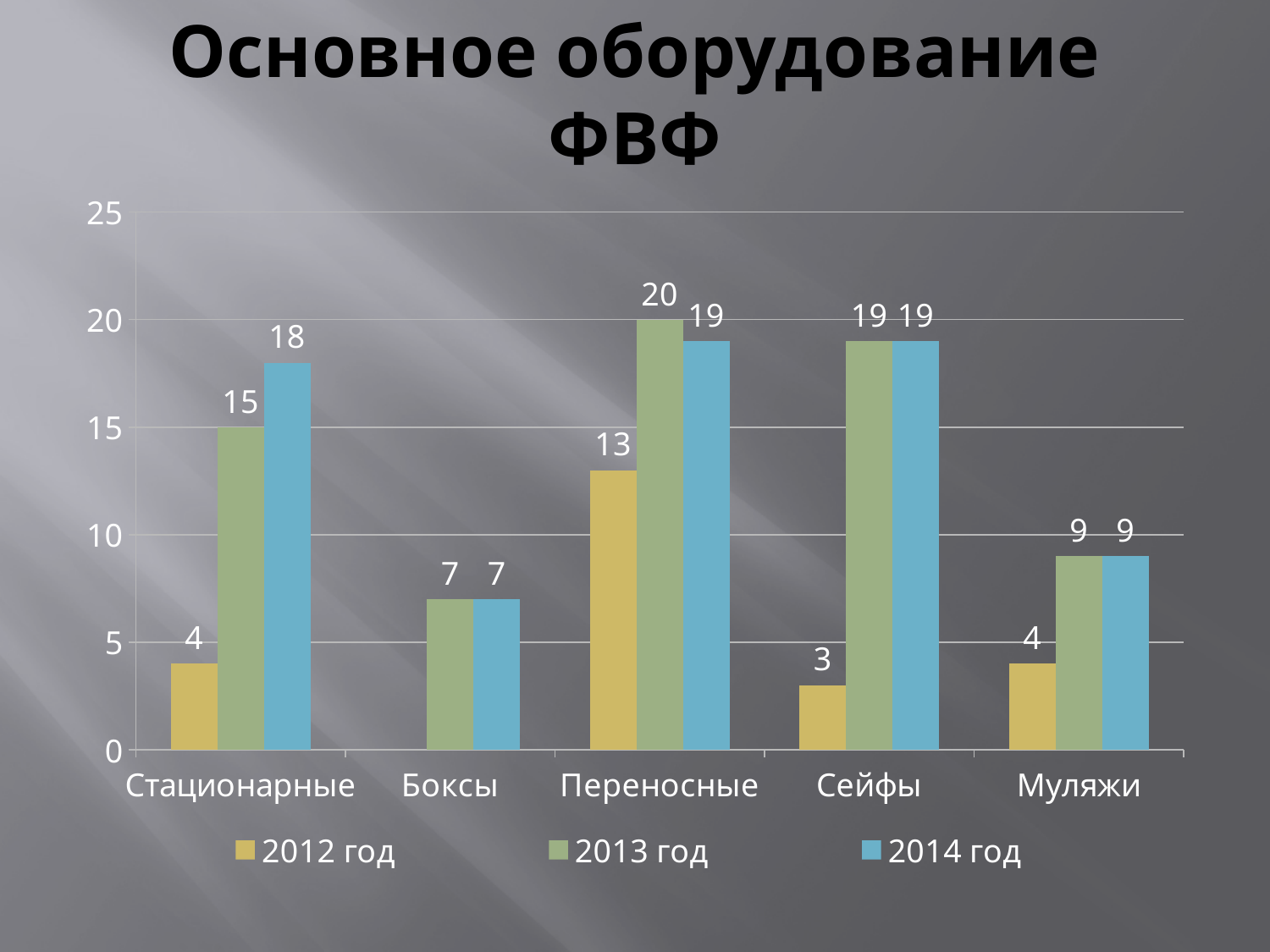
What kind of chart is shown on the slide? bar chart How many series does the legend list? 3 Which category has the highest value in the 2013 год series? Переносные How many categories are shown on the x axis? 5 What is the title of the chart? Основное оборудование ФВФ What is the value for Стационарные in the 2014 год series? 18 What is the value for Переносные in the 2012 год series? 13 Which category has the lowest value in the 2012 год series among those with a bar? Сейфы Is the 2013 год value for Муляжи greater or less than 10? less What is the value for Сейфы in the 2013 год series? 19 Which is larger for Переносные: the 2013 год value or the 2014 год value? 2013 год What is the difference between the 2014 год and 2012 год values for Стационарные? 14